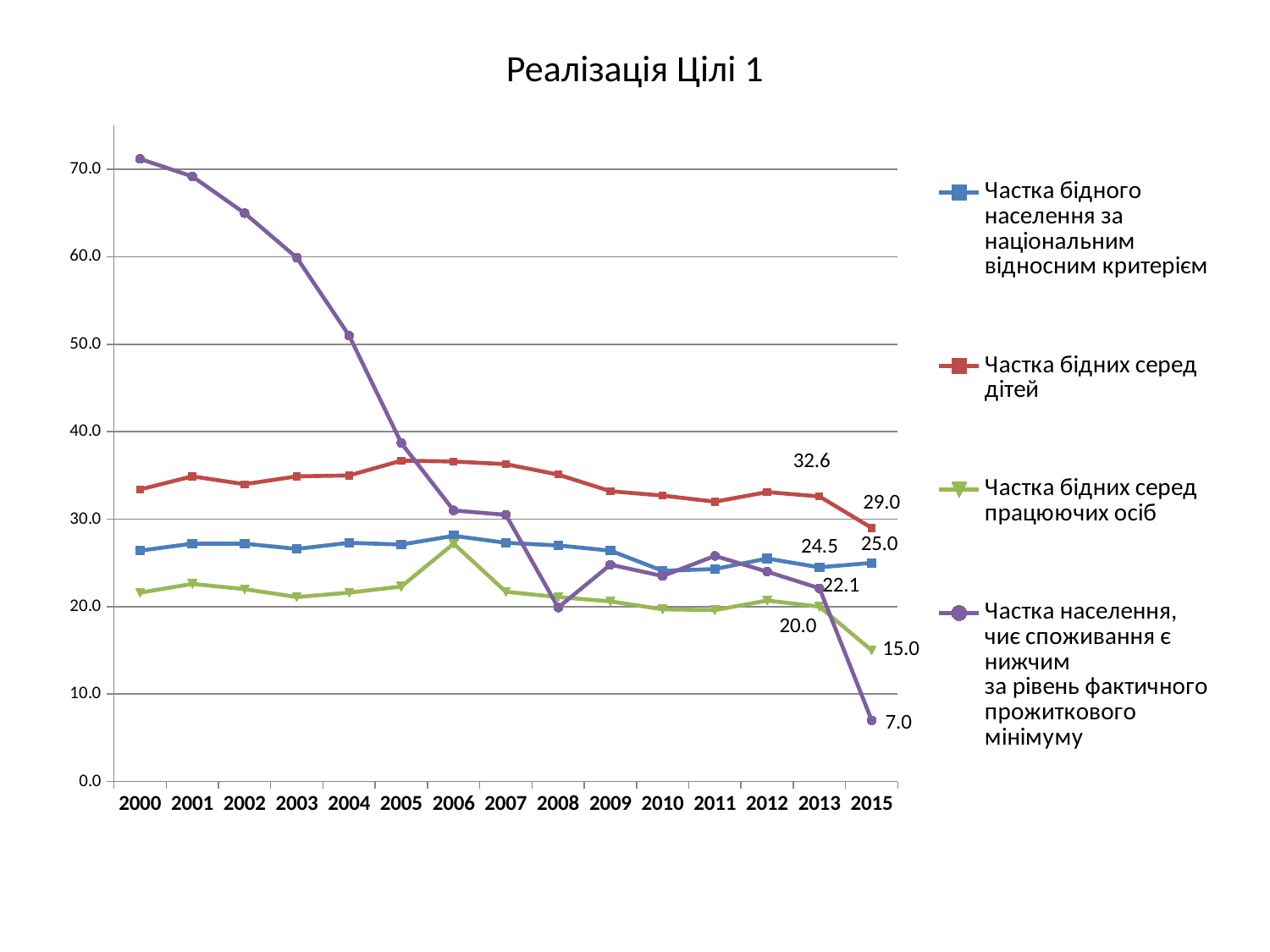
What is the value of Частка бідного населення за національним відносним критерієм in 2013? 24.5 What is the value of Частка бідних серед працюючих осіб in 2015? 15.0 What kind of chart is shown on the slide? line chart Does the series Частка населення, чиє споживання є нижчим за рівень фактичного прожиткового мінімуму rise or fall from 2000 to 2015? fall What is the value of Частка населення, чиє споживання є нижчим за рівень фактичного прожиткового мінімуму in 2015? 7.0 How many series does the legend list? 4 By how much did Частка бідних серед дітей decrease from 2013 to 2015? 3.6 Is the value for Частка населення, чиє споживання є нижчим за рівень фактичного прожиткового мінімуму in 2000 greater or less than 70.0? greater In 2015, which is larger: Частка бідних серед дітей or Частка бідних серед працюючих осіб? Частка бідних серед дітей How many years are shown on the x axis? 15 What is the value of Частка бідних серед дітей in 2015? 29.0 Which series has the lowest value in 2015? Частка населення, чиє споживання є нижчим за рівень фактичного прожиткового мінімуму